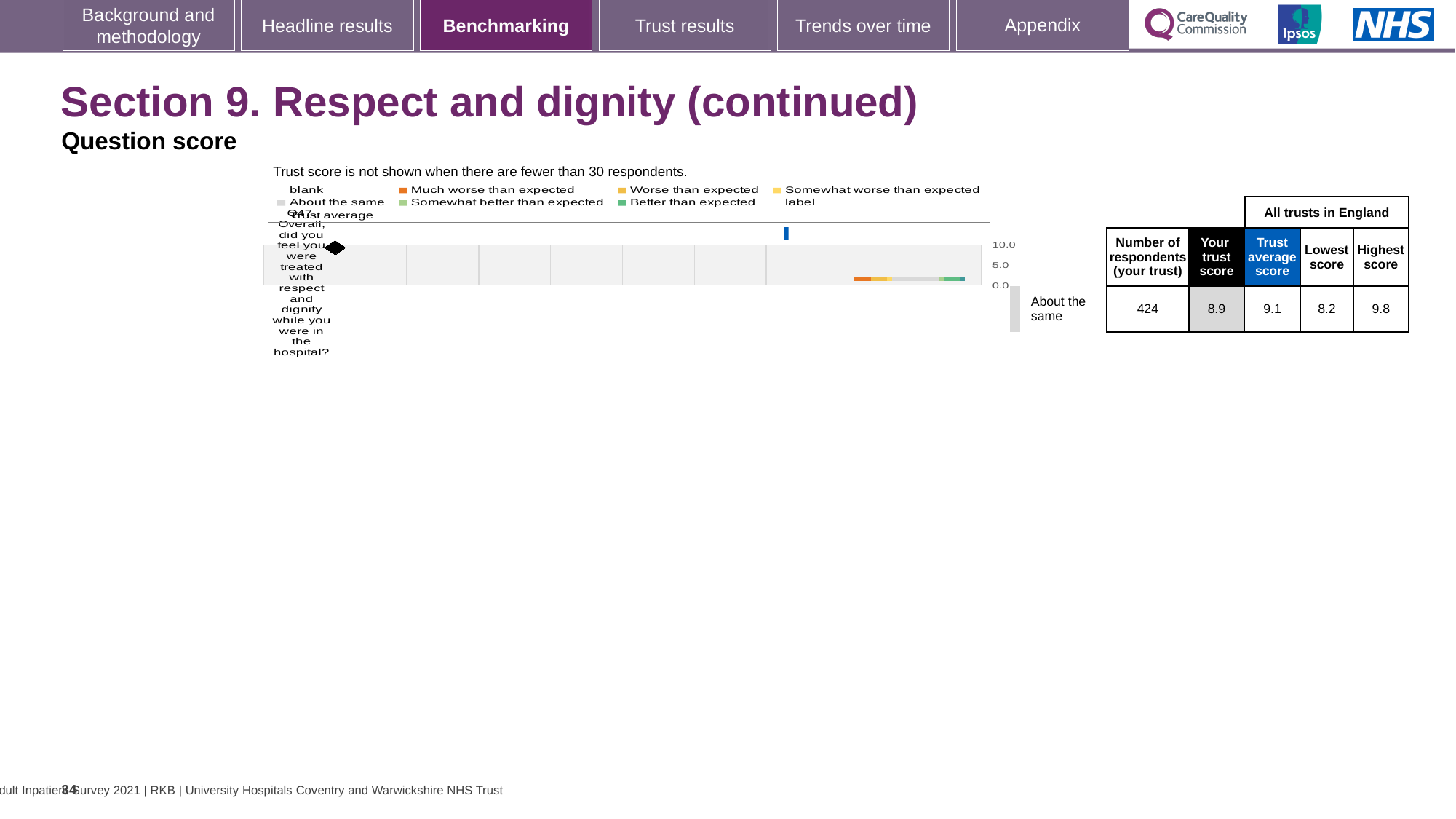
Which survey question is plotted in the chart? Q47 Overall, did you feel you were treated with respect and dignity while you were in the hospital? In the table next to the chart, what is the 'Lowest score' across all trusts in England for Q47? 8.2 What benchmark category is shown for your trust's Q47 score? About the same Which is larger for Q47: your trust score or the trust average score? Trust average score What is the difference between the highest score and the lowest score for Q47? 1.6 In the table next to the chart, what is the 'Your trust score' for Q47? 8.9 In the table next to the chart, what is the 'Trust average score' for Q47? 9.1 By how much does the trust average score exceed your trust score for Q47? 0.2 What kind of chart is shown on the slide? bar chart How many respondents from your trust answered Q47? 424 What is the highest tick value shown on the chart's score axis? 10.0 In the table next to the chart, what is the 'Highest score' across all trusts in England for Q47? 9.8